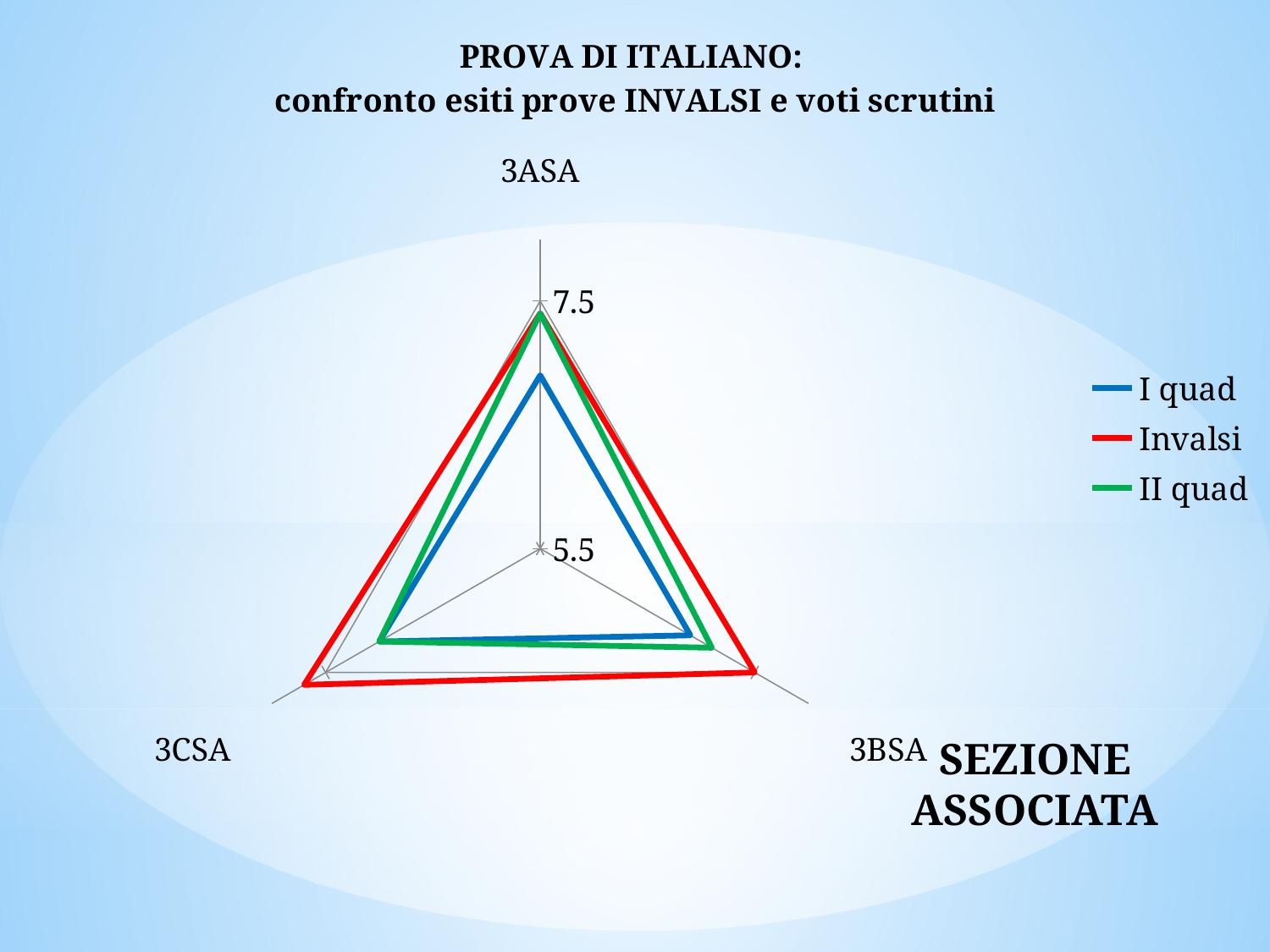
Is the Invalsi value for 3BSA greater or less than 5.5? greater Which series is shown in red in the legend? Invalsi For 3ASA, which is larger: the Invalsi value or the I quad value? Invalsi For 3CSA, which is larger: the Invalsi value or the II quad value? Invalsi Which series has the highest value for 3CSA? Invalsi What is the title of the chart? PROVA DI ITALIANO: confronto esiti prove INVALSI e voti scrutini What kind of chart is shown on the slide? Radar chart Is the I quad value for 3ASA greater or less than 7.5? less Which series has the lowest value for 3ASA? I quad How many categories (classes) are plotted on the radar chart? 3 How many series does the legend list? 3 Is the II quad value for 3CSA greater or less than 5.5? greater